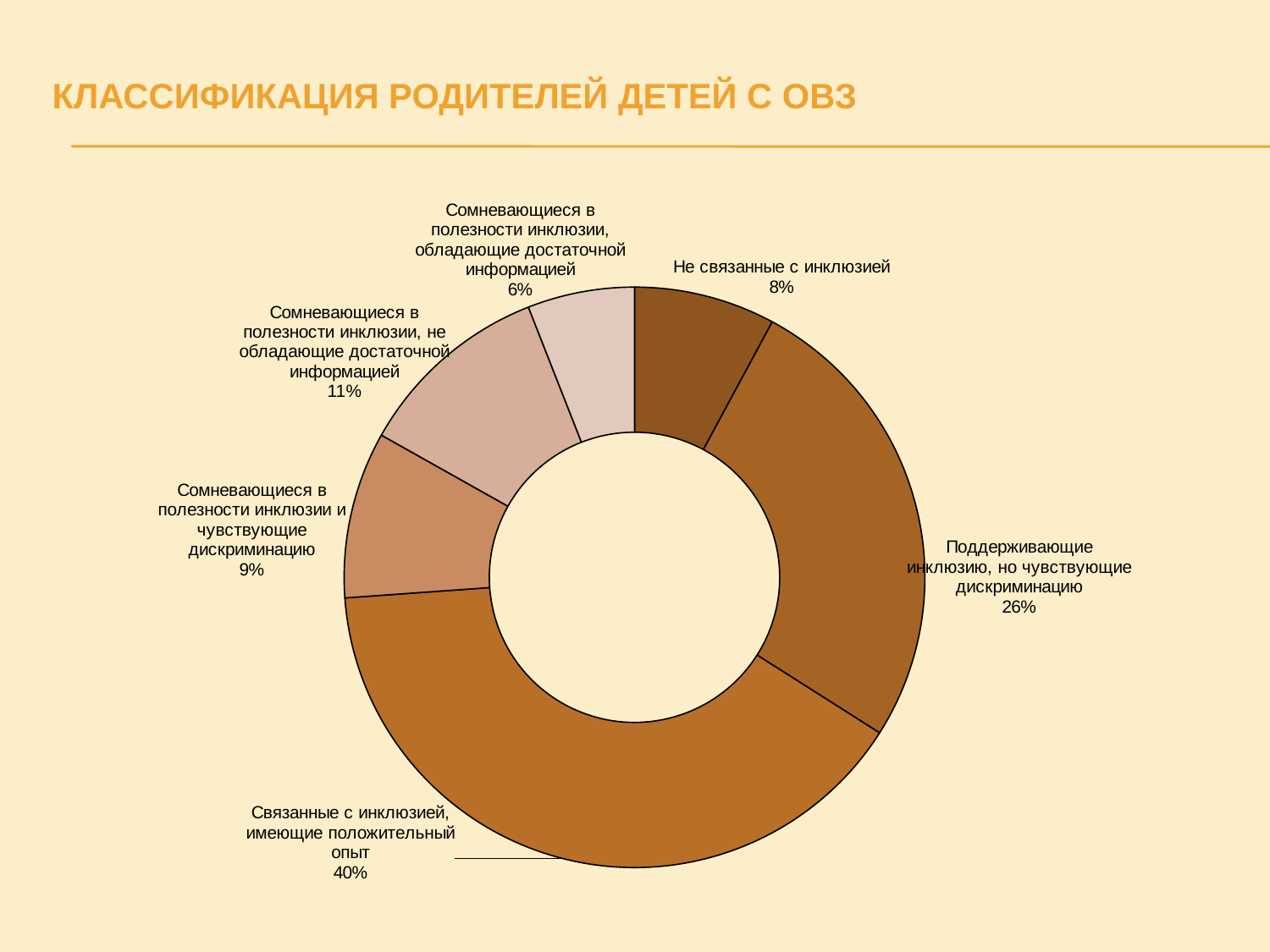
Which category has the smallest share of the chart? Сомневающиеся в полезности инклюзии, обладающие достаточной информацией What kind of chart is shown on the slide? Doughnut (pie) chart What percentage is shown for "Не связанные с инклюзией"? 8% What is the title of the slide? КЛАССИФИКАЦИЯ РОДИТЕЛЕЙ ДЕТЕЙ С ОВЗ How many categories are shown in the chart? 6 What percentage is shown for "Сомневающиеся в полезности инклюзии, не обладающие достаточной информацией"? 11% What share is shown for "Поддерживающие инклюзию, но чувствующие дискриминацию"? 26% Which category has the largest share of the chart? Связанные с инклюзией, имеющие положительный опыт What is the combined share of the three "Сомневающиеся в полезности инклюзии" categories? 26% Which is larger: the share for "Сомневающиеся в полезности инклюзии и чувствующие дискриминацию" or for "Не связанные с инклюзией"? Сомневающиеся в полезности инклюзии и чувствующие дискриминацию What is the difference in percentage points between "Связанные с инклюзией, имеющие положительный опыт" and "Поддерживающие инклюзию, но чувствующие дискриминацию"? 14 percentage points What share of parents are in the category "Связанные с инклюзией, имеющие положительный опыт"? 40%